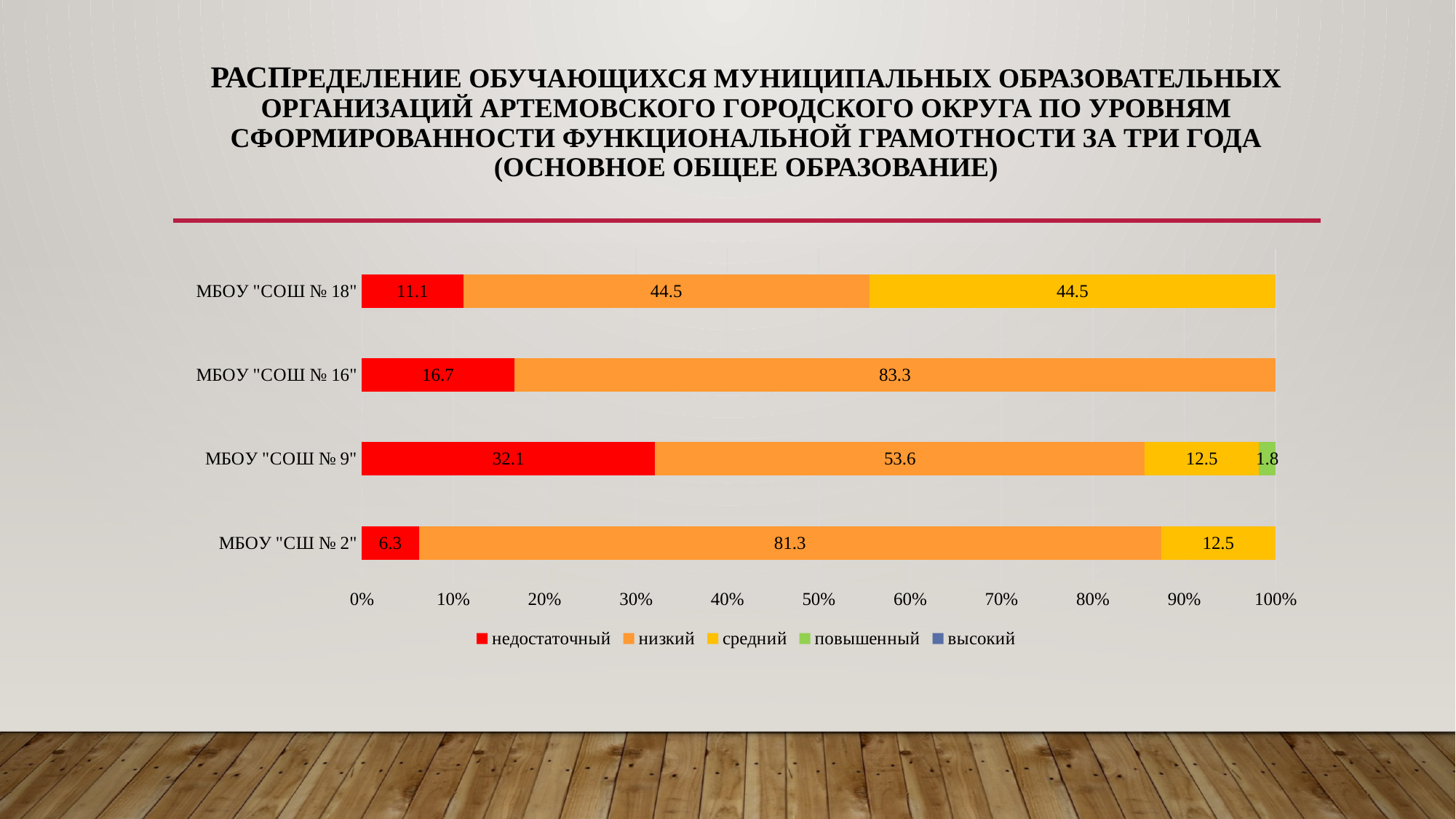
Which school has the highest "недостаточный" value? МБОУ "СОШ № 9" What is the difference between the "низкий" values of МБОУ "СОШ № 16" and МБОУ "СОШ № 18"? 38.8 Which is larger: the "средний" value for МБОУ "СОШ № 18" or for МБОУ "СОШ № 9"? МБОУ "СОШ № 18" How many schools (categories) are shown on the chart? 4 What is the value of the "повышенный" segment for МБОУ "СОШ № 9"? 1.8 What is the value of the "средний" segment for МБОУ "СШ № 2"? 12.5 Which series in the legend is shown in red? недостаточный Which school has the lowest "недостаточный" value? МБОУ "СШ № 2" How many series does the legend list? 5 What type of chart is shown on the slide? Stacked bar chart What is the value of the "низкий" segment for МБОУ "СОШ № 16"? 83.3 What is the value of the "недостаточный" segment for МБОУ "СОШ № 9"? 32.1